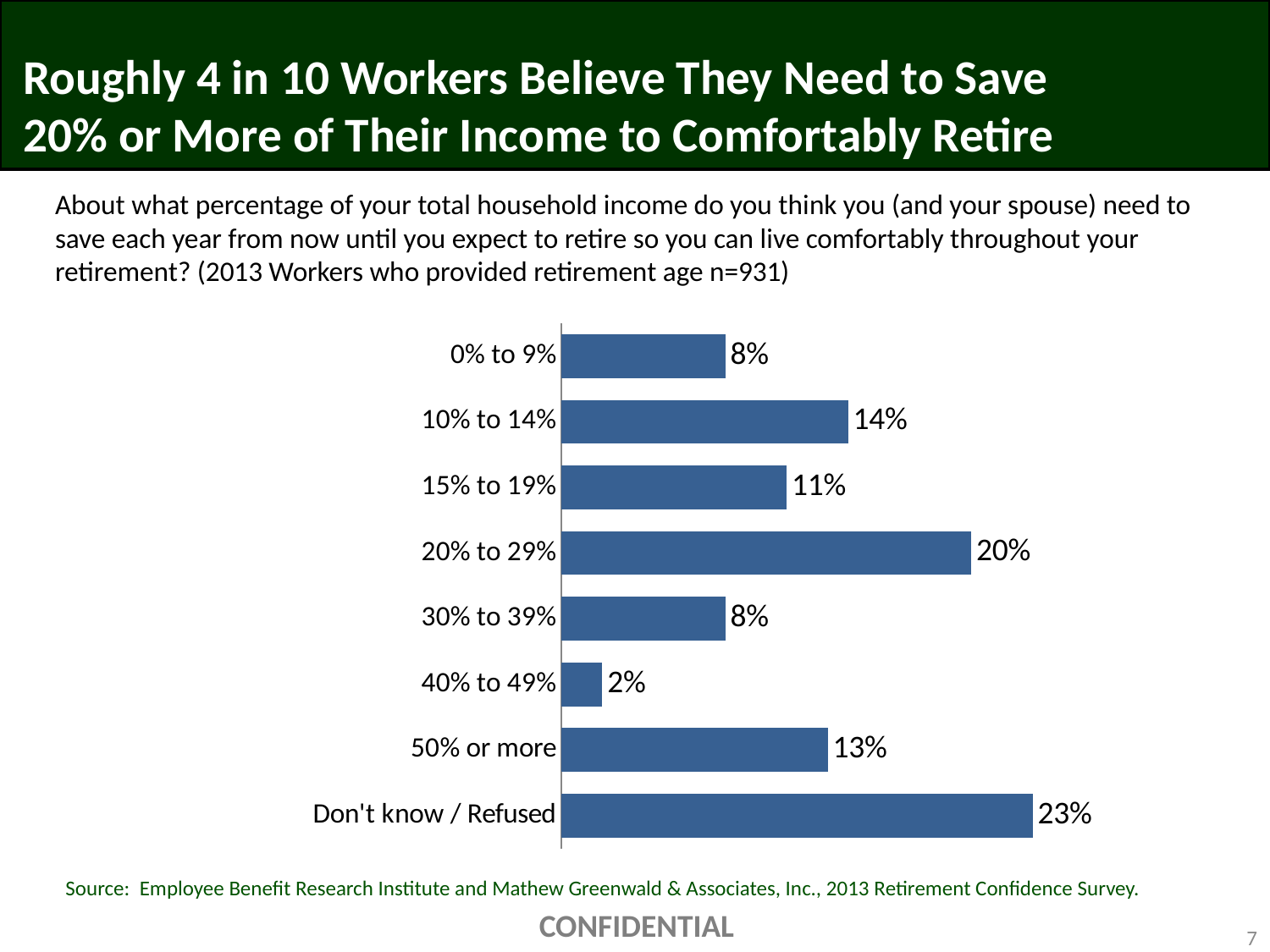
What kind of chart is shown on the slide? Bar chart What is the difference between the values for "20% to 29%" and "15% to 19%"? 9% What is the difference between the values for "Don't know / Refused" and "50% or more"? 10% Which is larger, the value for "10% to 14%" or the value for "15% to 19%"? 10% to 14% Which category has the highest value? Don't know / Refused What is the value for the "Don't know / Refused" category? 23% What is the value for the "40% to 49%" category? 2% What percentage of workers said they need to save 50% or more? 13% How many categories are shown in the chart? 8 Which category has the lowest value? 40% to 49% What percentage of workers said they need to save 20% to 29% of their income? 20% What is the combined value of the "0% to 9%" and "30% to 39%" categories? 16%